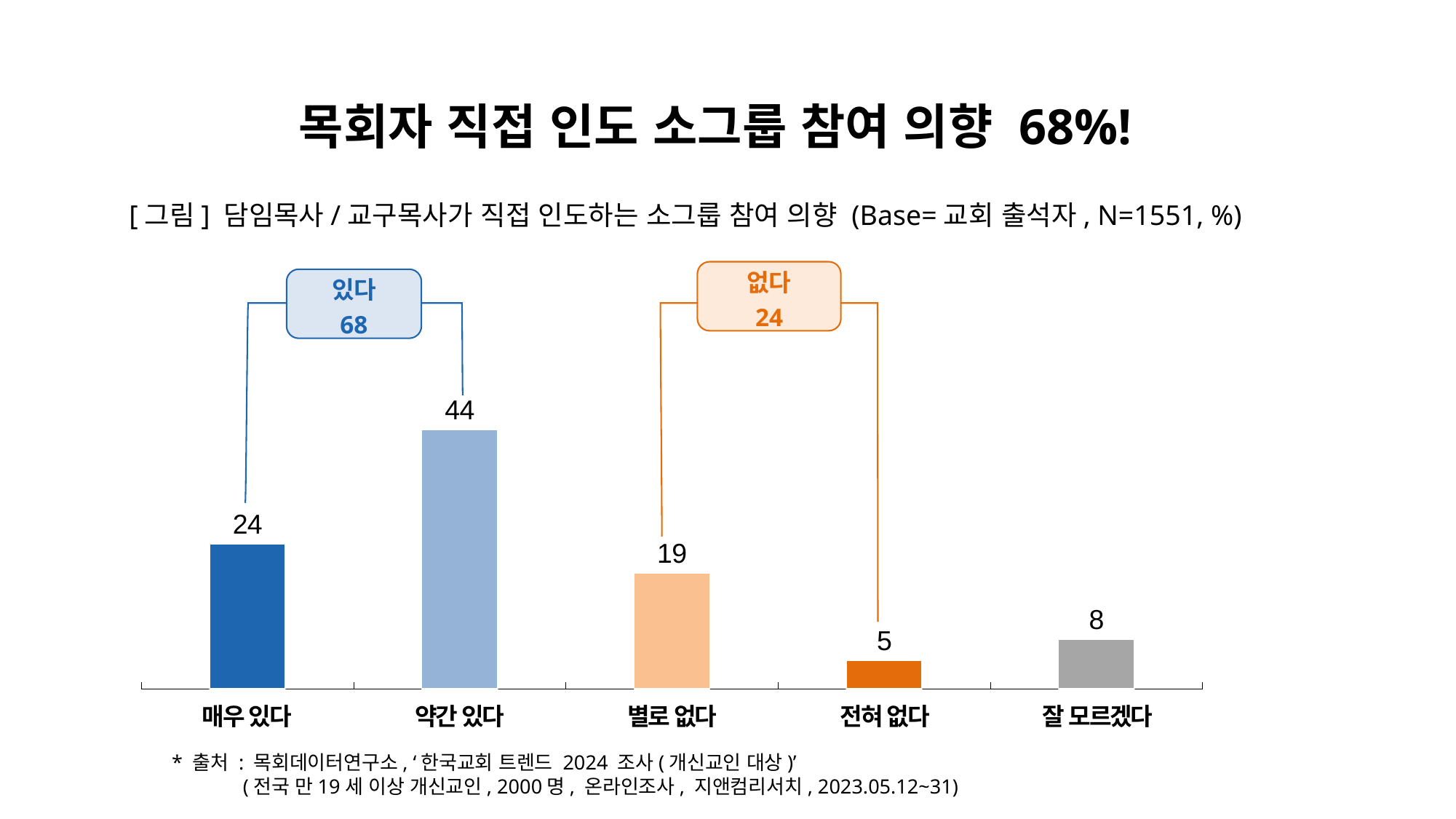
What kind of chart is shown on the slide? bar chart What is the value for 잘 모르겠다? 8 Which category has the lowest value? 전혀 없다 Which category has the highest value? 약간 있다 What is the value for 별로 없다? 19 Which is larger, the value for 별로 없다 or the value for 잘 모르겠다? 별로 없다 What is the value for 매우 있다? 24 What is the difference between the values for 약간 있다 and 매우 있다? 20 What combined value is shown in the 있다 bracket label above the first two bars? 68 How many categories are shown on the x axis? 5 What is the value for 약간 있다? 44 What is the value for 전혀 없다? 5